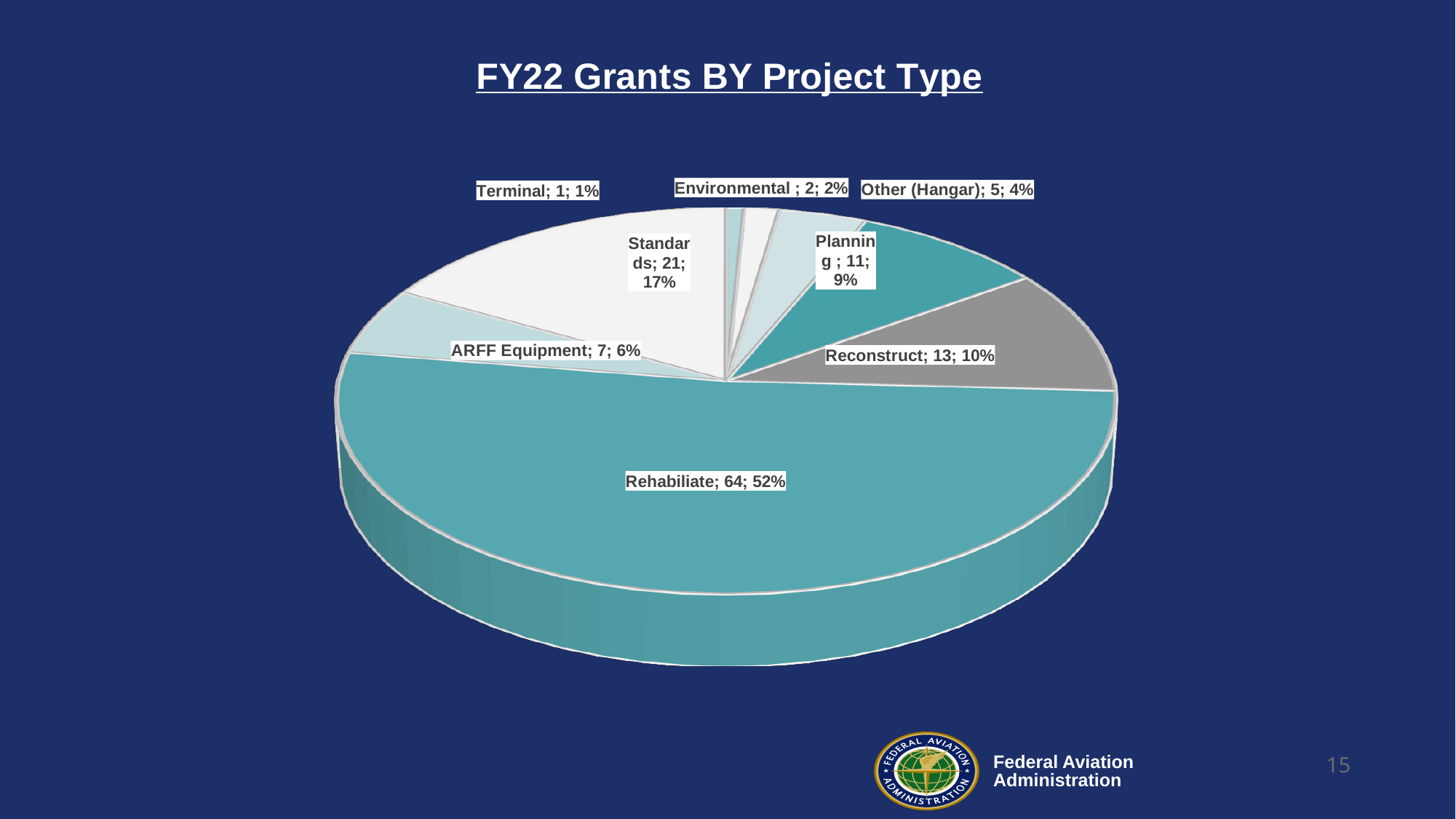
Which has more grants, Planning or Other (Hangar)? Planning What is the difference between the number of grants for Standards and for ARFF Equipment? 14 What kind of chart is shown on the slide? Pie chart Which project type has the largest slice? Rehabiliate Which project type has the smallest slice? Terminal What percentage share does the Planning slice have? 9% What is the percentage share of the Environmental slice? 2% How many slices does the pie chart have? 8 What is the title of the chart? FY22 Grants BY Project Type How many grants are shown for Reconstruct? 13 What percentage share does the Standards slice have? 17% How many grants are shown for Rehabilitate? 64